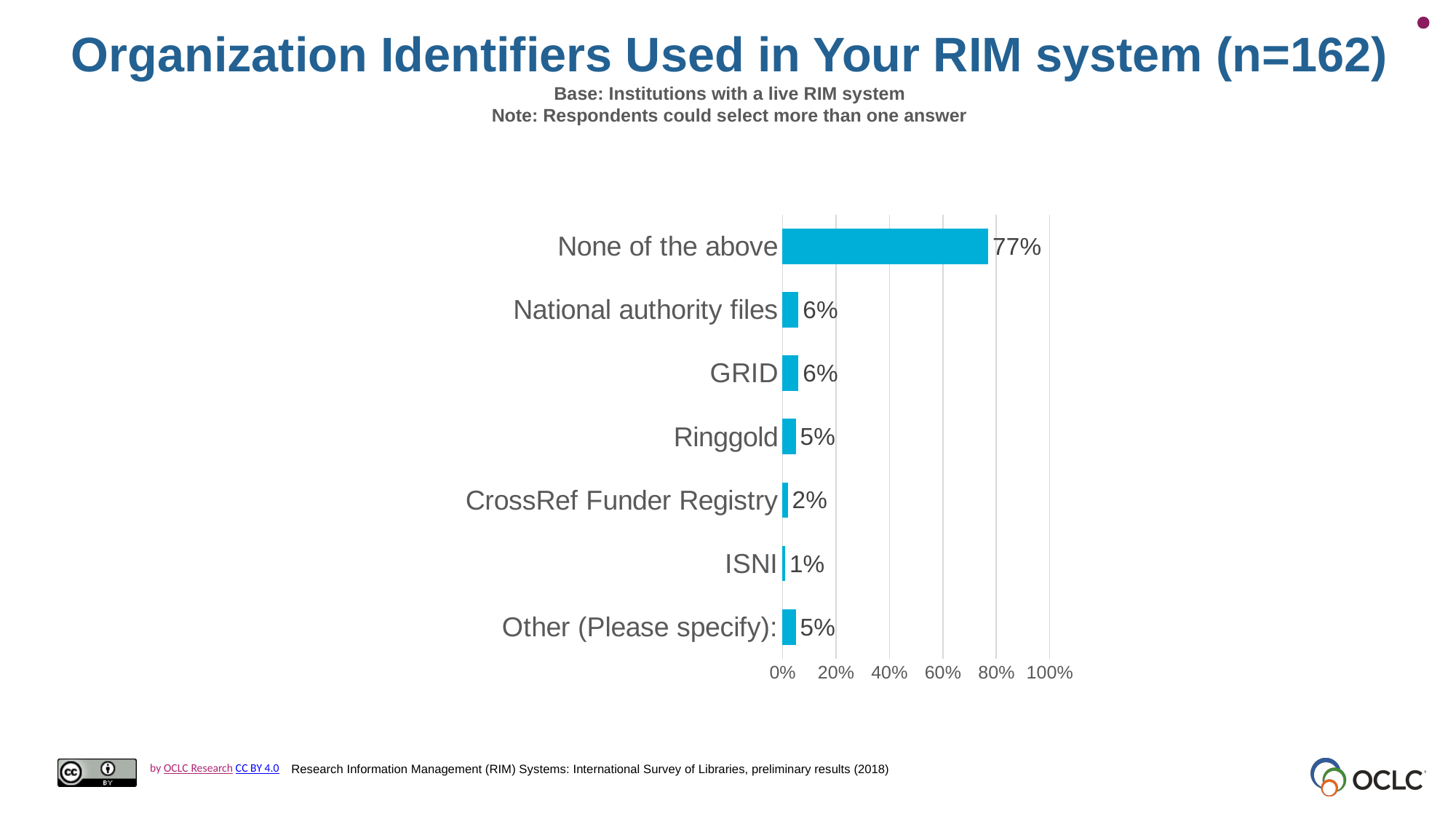
What kind of chart is shown on the slide? bar chart What is the title of the chart on the slide? Organization Identifiers Used in Your RIM system (n=162) Which is larger, the value for Ringgold or the value for CrossRef Funder Registry? Ringgold What is the value for CrossRef Funder Registry? 2% Which category has the lowest value? ISNI Which category has the highest value? None of the above What is the value for GRID? 6% What is the value for ISNI? 1% What percentage of respondents selected "None of the above"? 77% Is the value for "None of the above" greater or less than 60%? greater How many categories are shown in the chart? 7 What is the difference between the values for "None of the above" and National authority files? 71%